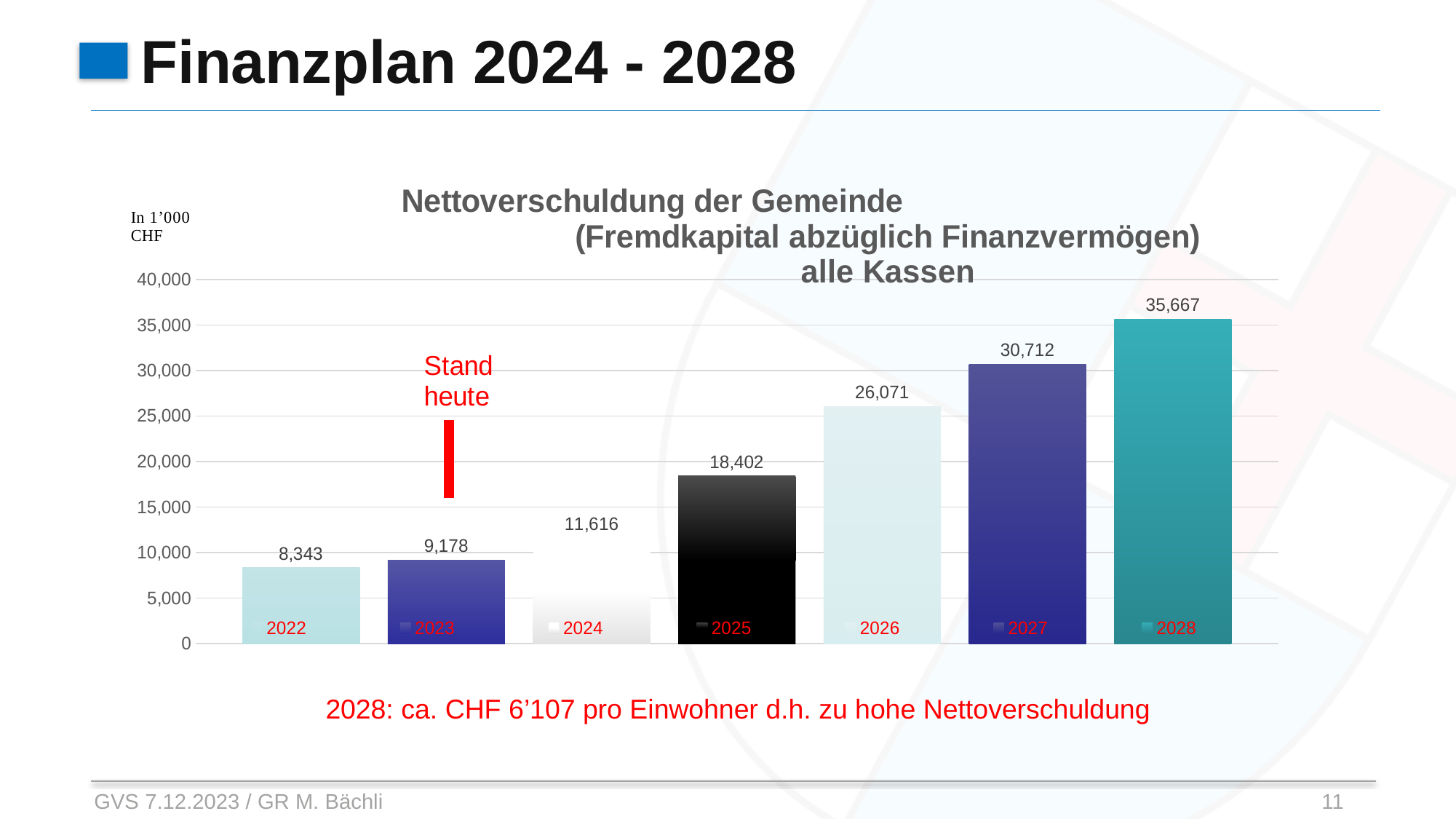
What is the value shown for 2028? 35,667 Which year has the lowest net debt? 2022 What kind of chart is shown on the slide? bar chart Which year has the highest net debt? 2028 Which is larger, the value for 2026 or the value for 2025? 2026 What is the difference between the values for 2028 and 2027? 4,955 Is the value for 2027 greater or less than 30,000? greater What is the value shown for 2022? 8,343 What is the net debt value shown for 2025? 18,402 How many years are shown on the x axis? 7 Do the values rise or fall from 2022 to 2028? rise What is the difference between the values for 2024 and 2023? 2,438